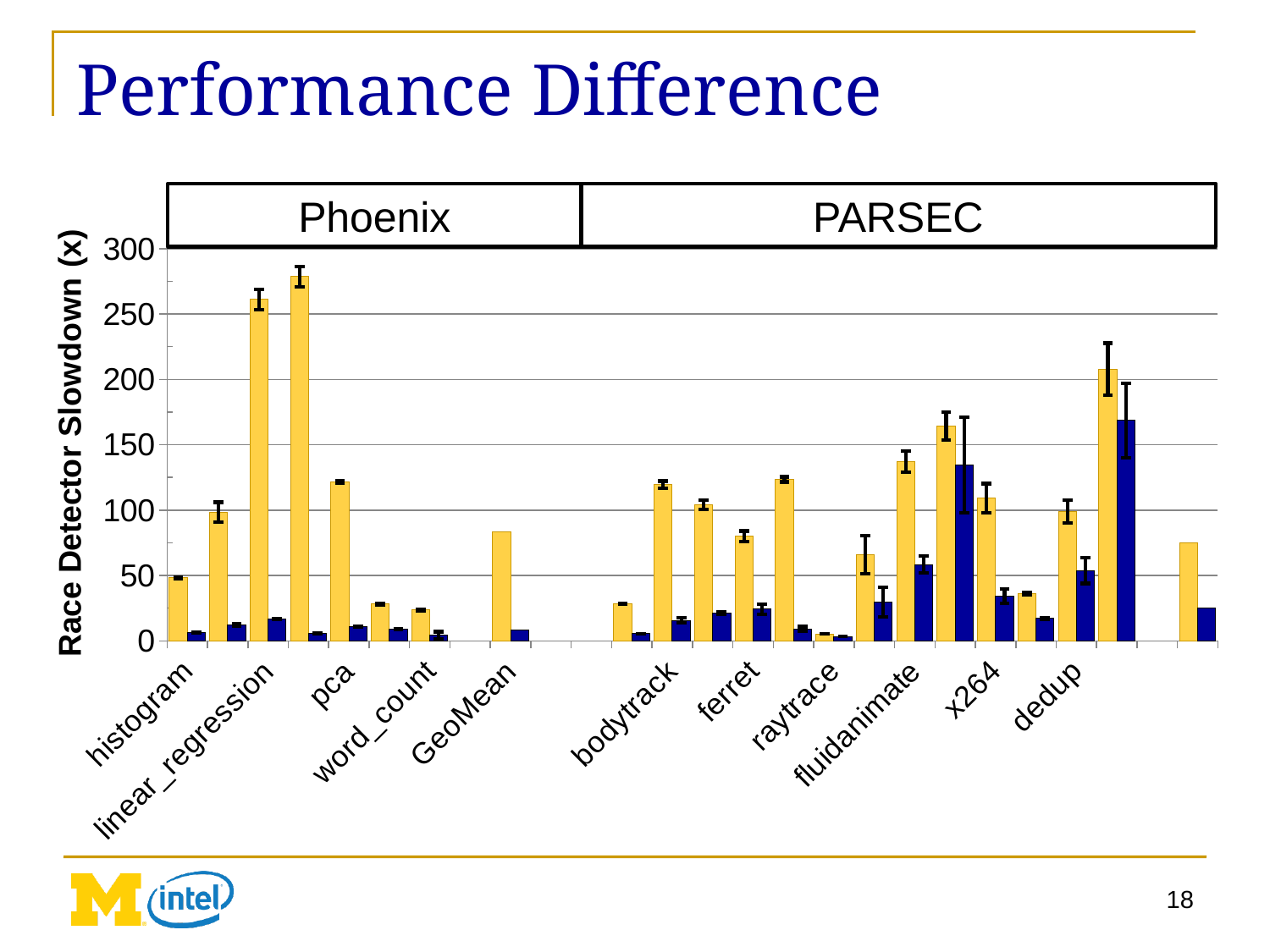
What is the label of the vertical axis of the chart? Race Detector Slowdown (x) Is the tallest bar in the chart greater or less than 250? greater How many category labels are listed under the PARSEC section of the chart? 6 How many category labels are listed under the Phoenix section of the chart? 5 Which benchmark suite section, Phoenix or PARSEC, contains the tallest bar in the chart? Phoenix Is the yellow GeoMean bar in the Phoenix section greater or less than 100? less What are the two benchmark suite headings shown above the chart? Phoenix and PARSEC How many tick values are labelled on the vertical axis of the chart? 7 Is the yellow GeoMean bar in the Phoenix section greater or less than 50? greater Which colour of bars, yellow or blue, is generally taller across the chart? yellow What kind of chart is shown on the slide? bar chart What is the highest value shown on the vertical axis of the chart? 300